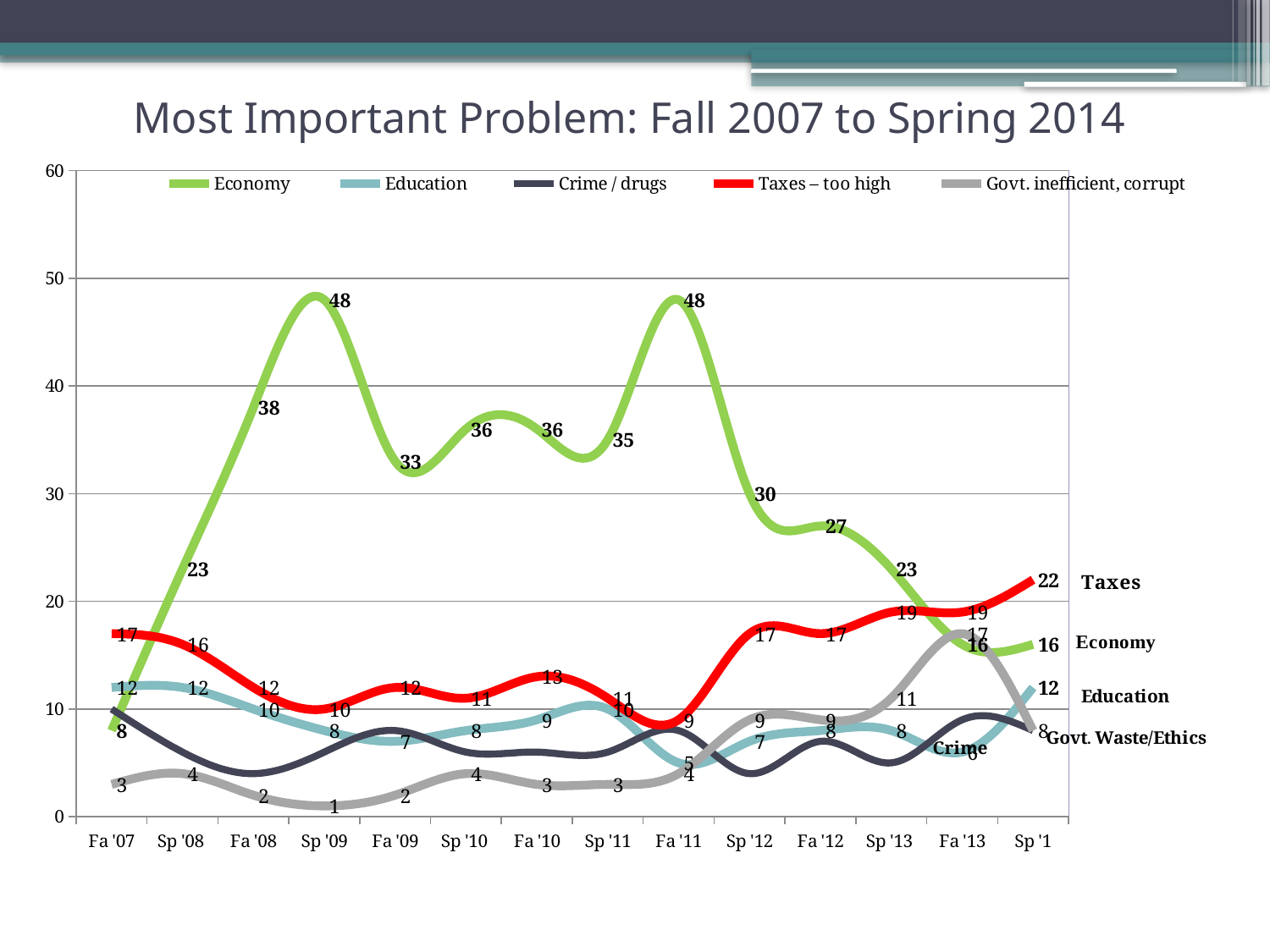
What is the value for Govt. inefficient, corrupt at Sp '09? 1 Does the Taxes – too high series rise or fall from Fa '11 to Sp '14? Rise What is the value for Economy at Sp '09? 48 How many series does the legend list? 5 What is the highest value reached by the Economy series? 48 What is the title of the chart? Most Important Problem: Fall 2007 to Spring 2014 What type of chart is shown on the slide? Line chart At which time point is the Economy series at its lowest value? Fa '07 At Fa '08, which is larger: the value for Economy or the value for Taxes – too high? Economy What is the value for Taxes – too high at Sp '14 (the last point)? 22 How many time points are shown along the x axis? 14 What is the difference between the Economy values at Sp '09 and Fa '09? 15